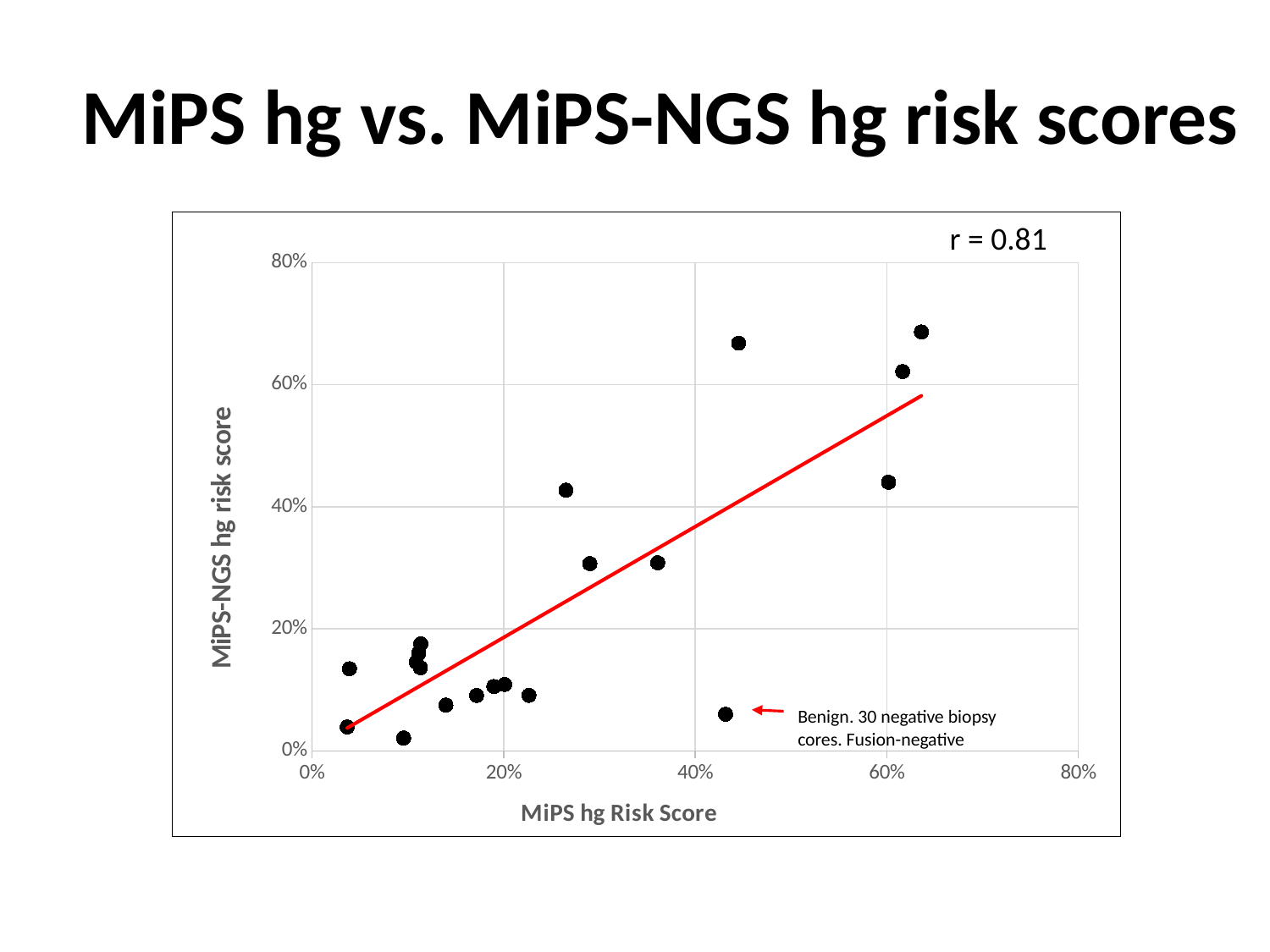
Do the MiPS-NGS hg risk scores generally rise or fall as the MiPS hg Risk Score increases along the x axis? rise Is the highest MiPS-NGS hg risk score plotted greater or less than 60%? greater Is the MiPS-NGS hg risk score of the point with the highest MiPS hg Risk Score greater or less than 60%? greater Is the MiPS hg Risk Score of the point labelled 'Benign' greater or less than 60%? less What correlation coefficient (r) is printed on the chart? 0.81 What text does the red arrow annotation on the chart point to? Benign. 30 negative biopsy cores. Fusion-negative What kind of chart is shown on the slide? scatter plot